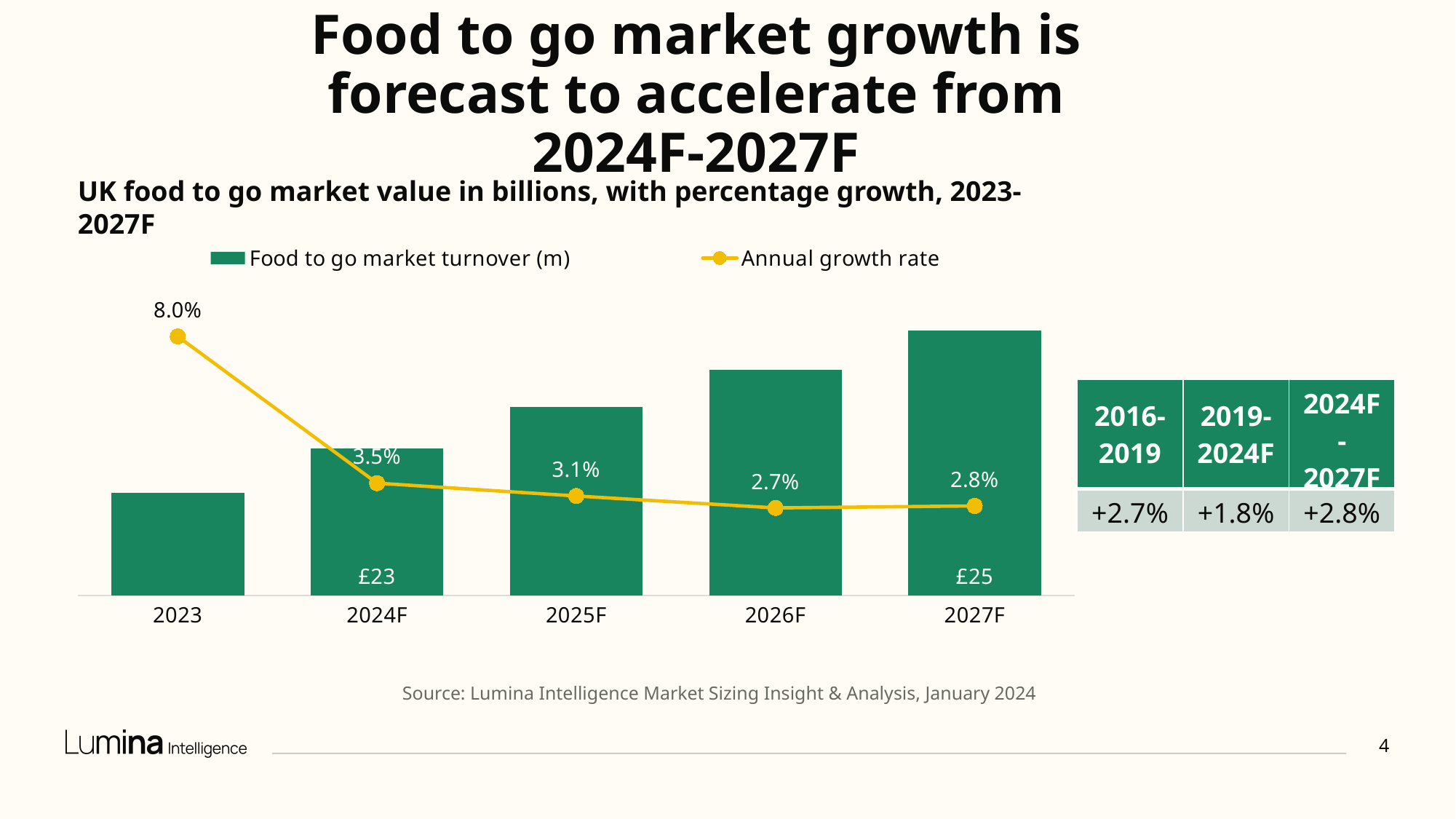
What is the food to go market turnover for 2027F? £25 Which year has the highest annual growth rate? 2023 How many years are shown on the x axis? 5 Which has the higher annual growth rate, 2025F or 2027F? 2025F Do the market turnover bars rise or fall from 2023 to 2027F? rise Which year has the lowest annual growth rate? 2026F What is the annual growth rate for 2026F? 2.7% By how many percentage points does the annual growth rate fall from 2023 to 2024F? 4.5 percentage points How many series does the legend list? 2 What is the annual growth rate for 2023? 8.0% What is the food to go market turnover for 2024F? £23 What is the difference in market turnover between 2027F and 2024F? £2